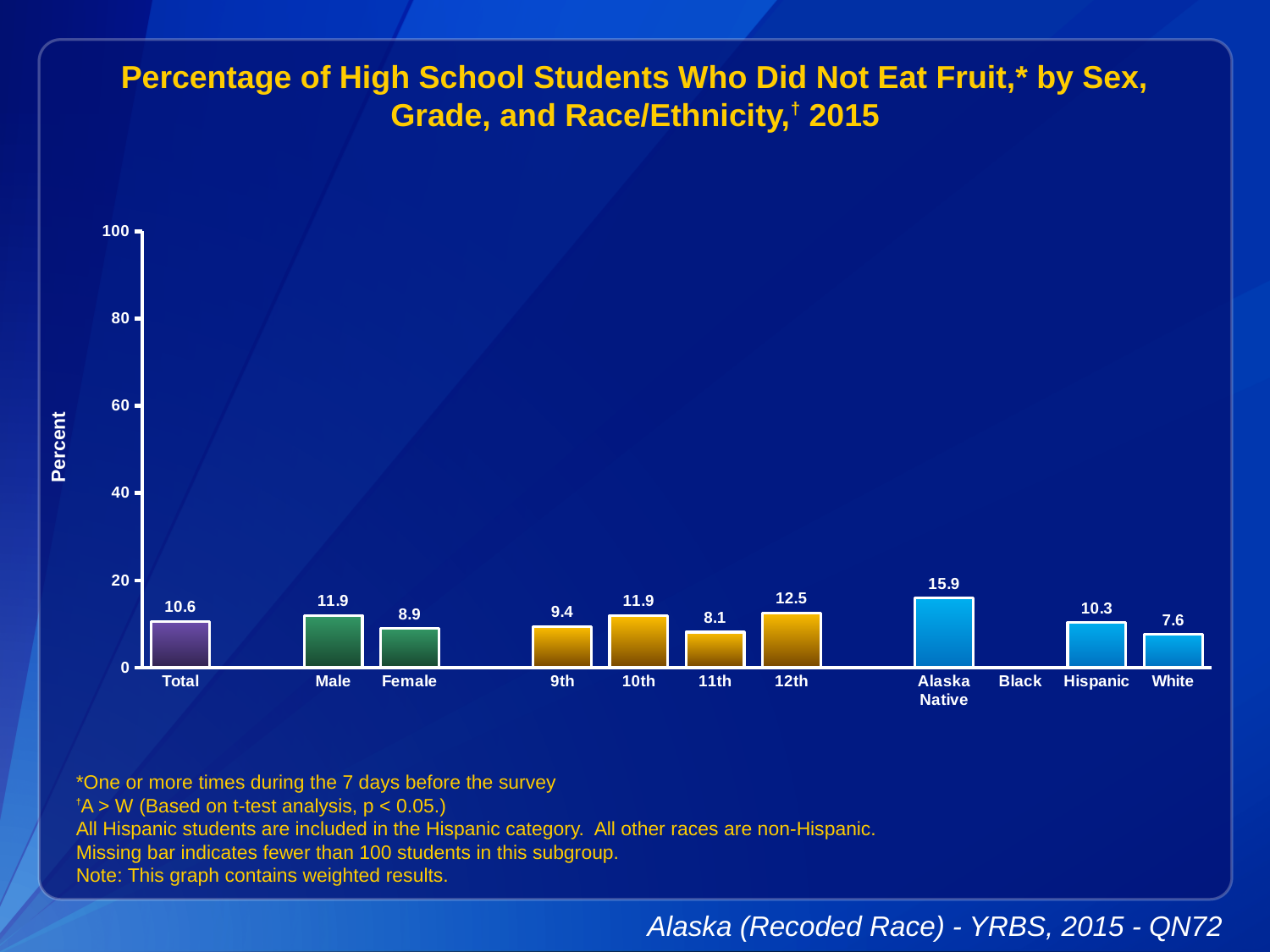
What is the value for Female? 8.9 How many categories have a bar plotted? 10 What is the value for Alaska Native? 15.9 Which category has no bar shown? Black What is the value for Total? 10.6 Which category has the lowest value among those with a bar shown? White What is the value for 11th grade? 8.1 Which category has the highest value? Alaska Native What kind of chart is shown? bar chart What is the difference between the Male and Female values? 3.0 Which is larger, the value for 12th grade or the value for 9th grade? 12th Is the value for Alaska Native greater or less than 20? less